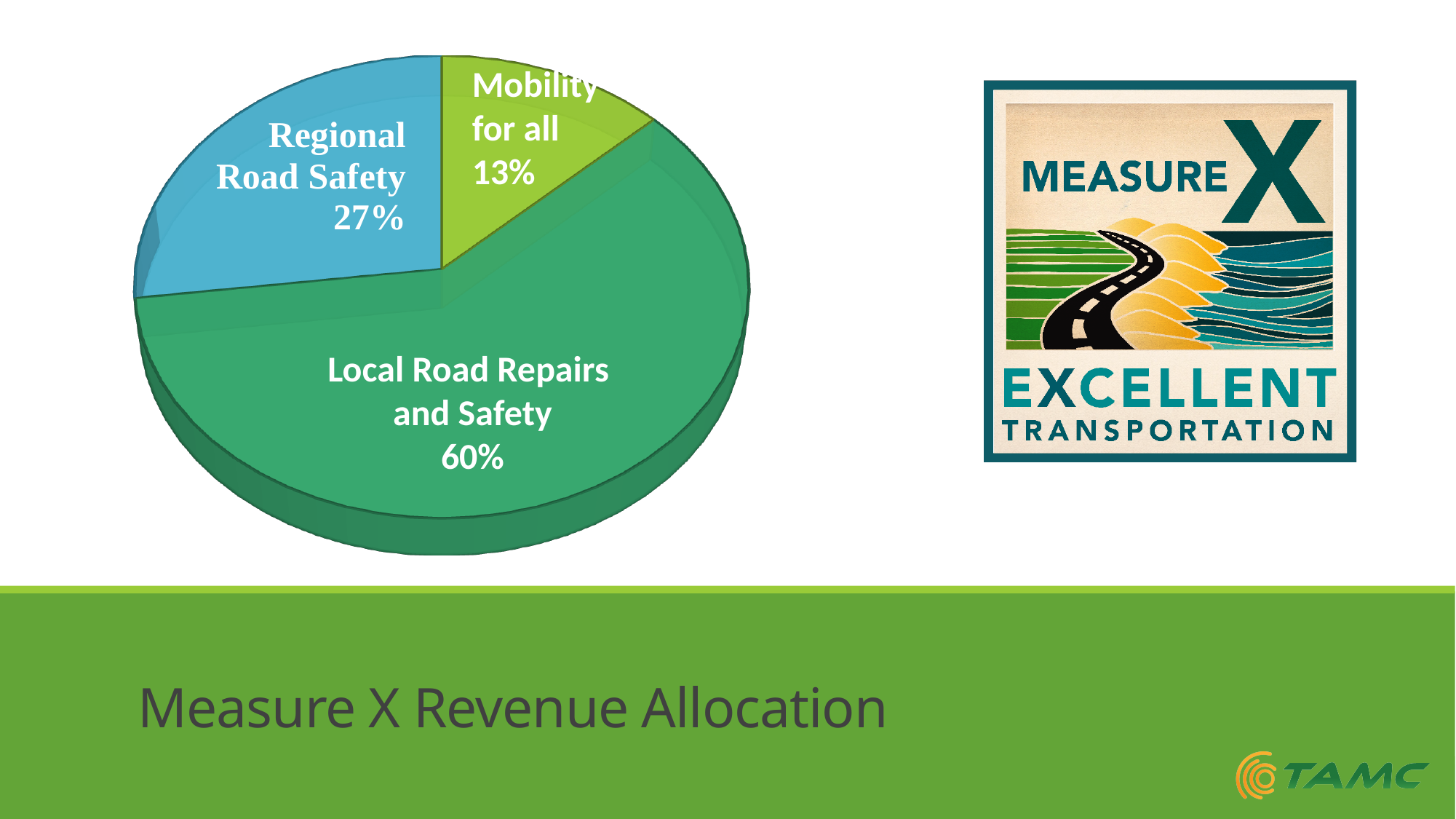
What is the title of the slide containing the pie chart? Measure X Revenue Allocation Which receives a larger share: Regional Road Safety or Mobility for all? Regional Road Safety Which category receives the largest share of Measure X revenue? Local Road Repairs and Safety What share of Measure X revenue is allocated to Regional Road Safety? 27% What share of Measure X revenue is allocated to Mobility for all? 13% Which category receives the smallest share of Measure X revenue? Mobility for all What kind of chart is used to show the Measure X revenue allocation? Pie chart What share of Measure X revenue is allocated to Local Road Repairs and Safety? 60% What colour is the Regional Road Safety slice of the pie chart? Blue What is the difference in percentage points between Regional Road Safety and Mobility for all? 14 What is the difference in percentage points between Local Road Repairs and Safety and Regional Road Safety? 33 How many categories are shown in the pie chart? 3